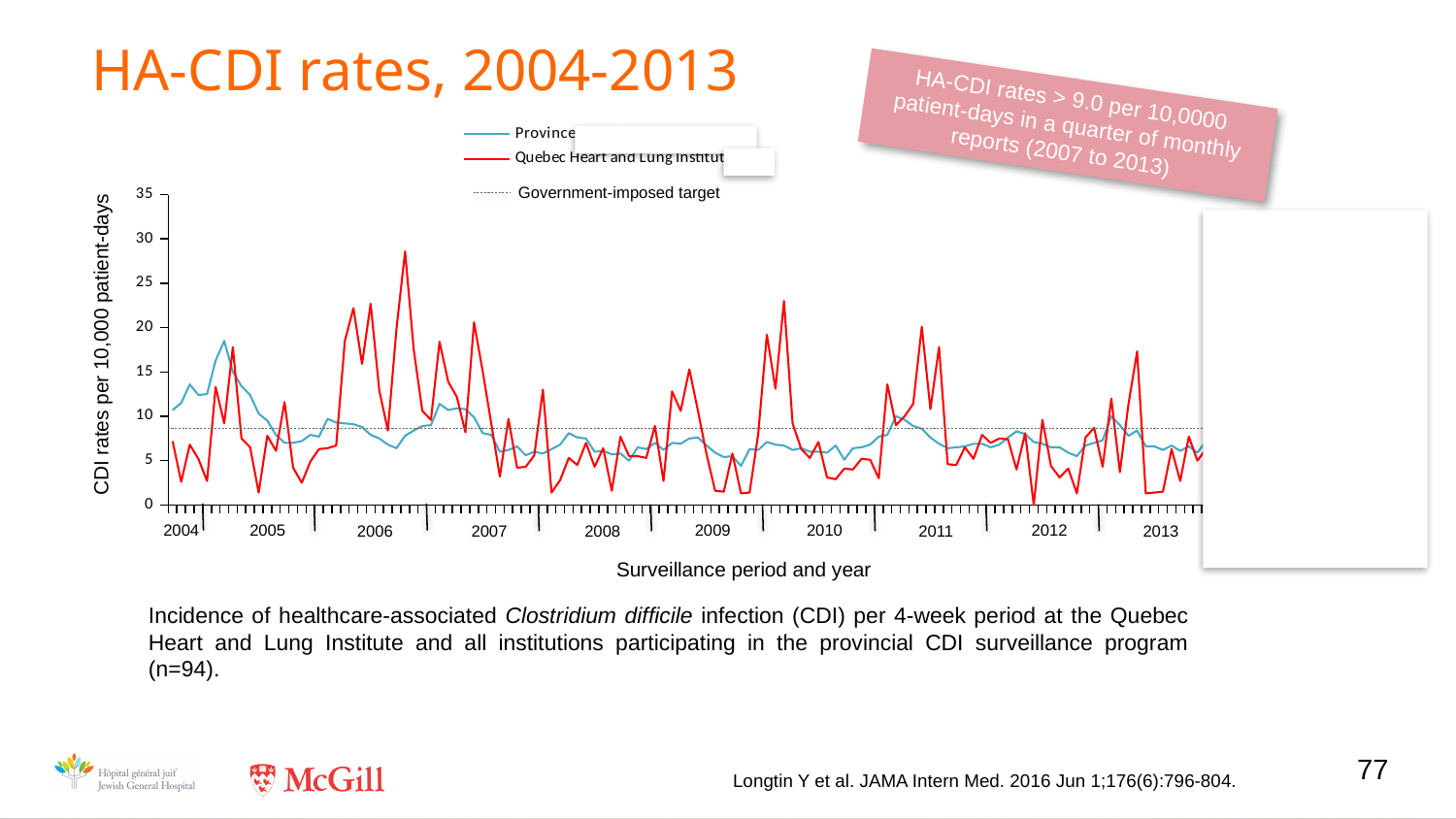
Is the peak of the Province series in 2004 greater or less than 15? greater Which series reaches a higher peak value, Province or Quebec Heart and Lung Institute? Quebec Heart and Lung Institute In which year does the Quebec Heart and Lung Institute series reach its highest value? 2006 What kind of chart is shown on the slide? line chart What is the label of the y axis of the chart? CDI rates per 10,000 patient-days Is the government-imposed target line greater or less than 10 CDI rates per 10,000 patient-days? less Is the highest value of the Quebec Heart and Lung Institute series greater or less than 25? greater How many entries does the chart legend list? 3 Does the Province series generally rise or fall from 2004 to 2013? fall What is the label of the x axis of the chart? Surveillance period and year How many years are labelled along the x axis of the chart? 10